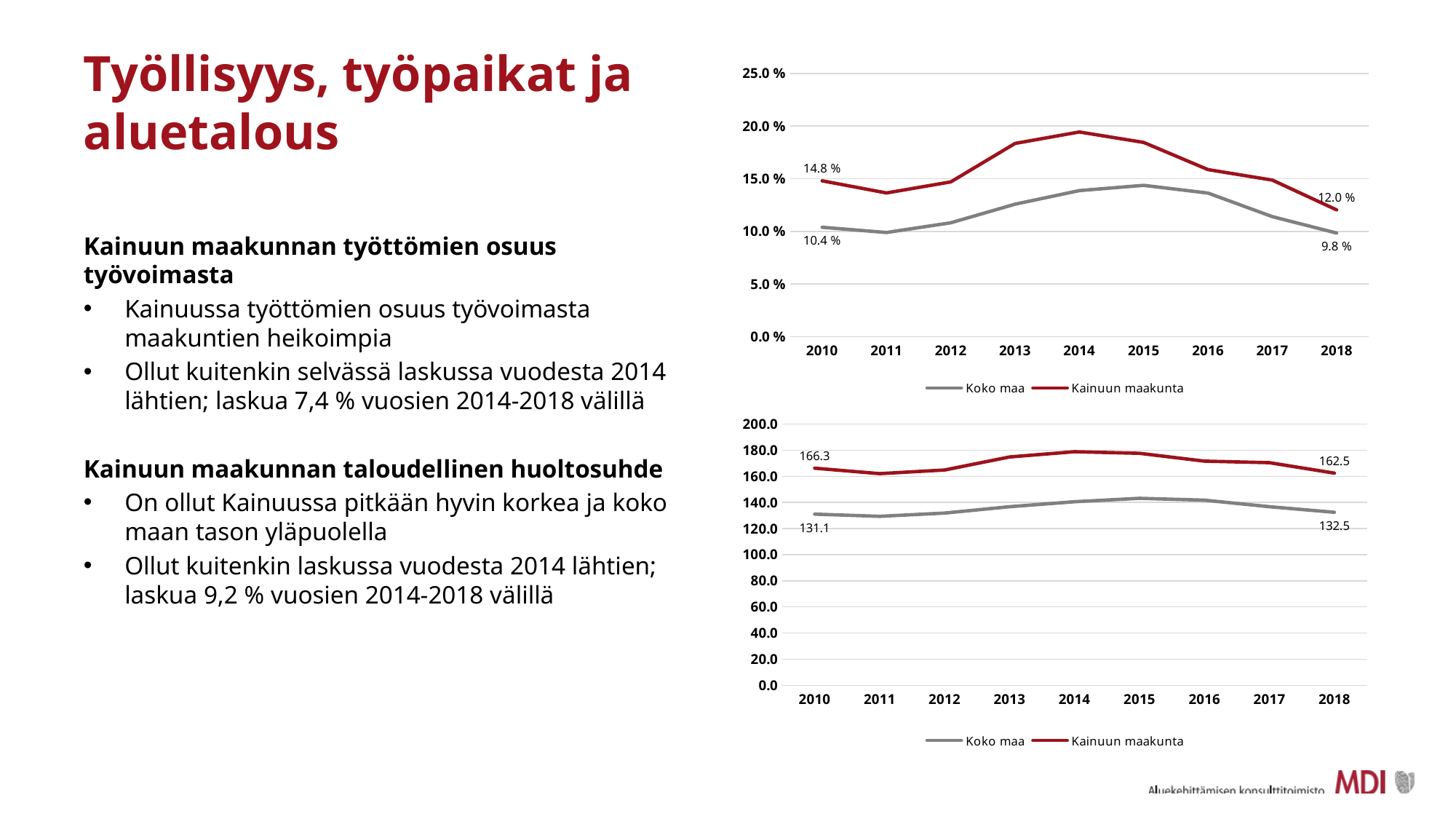
In the top chart, in which year does the Kainuun maakunta line reach its highest value? 2014 In the bottom chart, what is the value for Koko maa in 2010? 131.1 In the top chart, is the value for Kainuun maakunta in 2014 greater or less than 15.0 %? greater In the top chart, which series has the higher value in 2018, Koko maa or Kainuun maakunta? Kainuun maakunta In the bottom chart, is the value for Koko maa in 2014 greater or less than 160.0? less What type of chart is the top chart? line chart In the top chart, what is the value for Koko maa in 2018? 9.8 % How many years are shown on the x axis of the bottom chart? 9 In the top chart, what is the value for Kainuun maakunta in 2010? 14.8 % In the top chart, what is the difference between the Kainuun maakunta values in 2010 and 2018? 2.8 % In the bottom chart, what is the value for Kainuun maakunta in 2018? 162.5 In the bottom chart, what is the difference between the Kainuun maakunta values in 2010 and 2018? 3.8